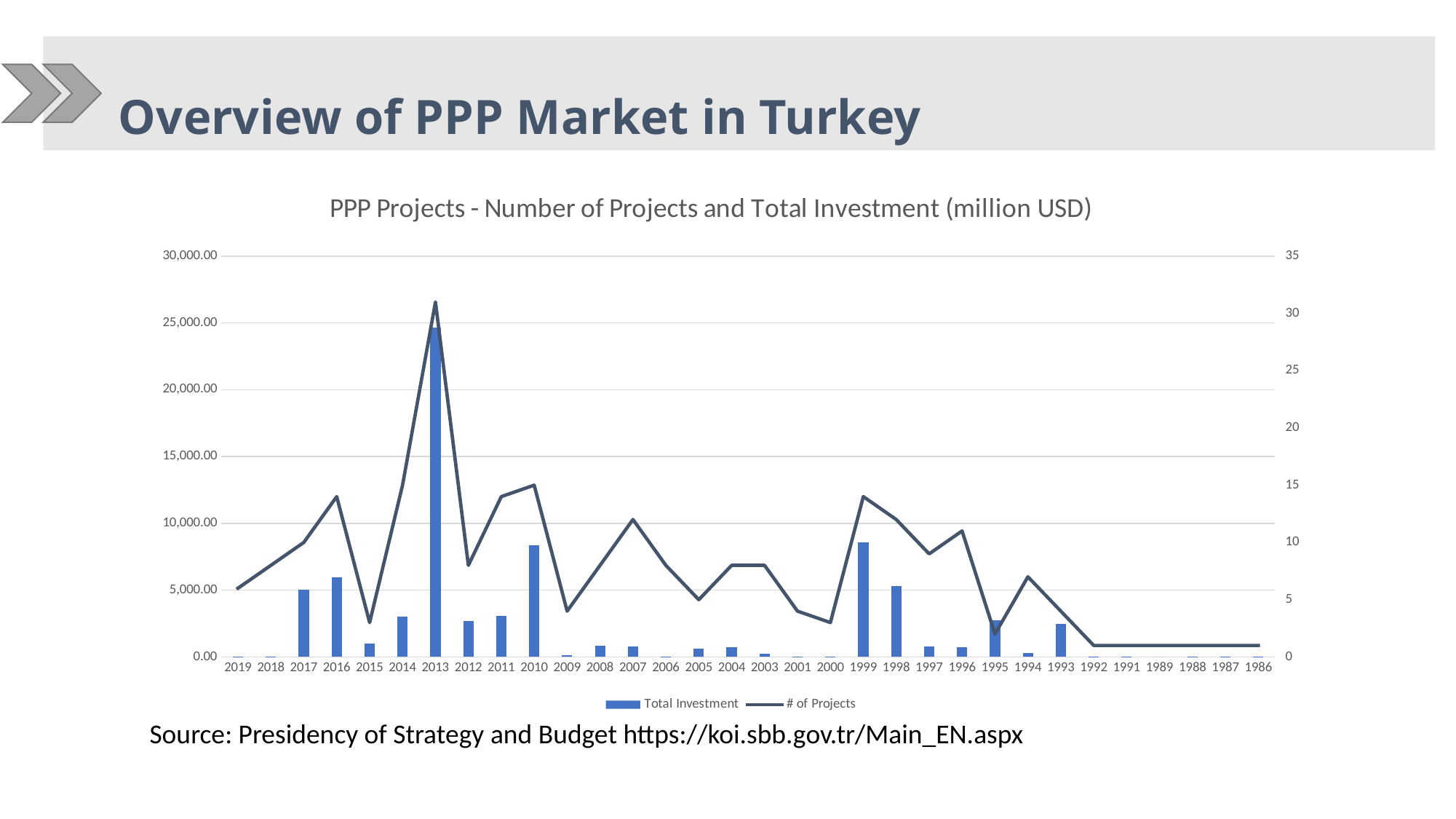
How many years are shown along the x axis of the chart? 32 Is the # of Projects for 2015 greater or less than 5? less Which year has the highest # of Projects? 2013 What is the title of the chart? PPP Projects - Number of Projects and Total Investment (million USD) Moving from 2019 to 2016 along the x axis, does the # of Projects line rise or fall? rise What kind of chart is shown on the slide? Combined bar and line chart Which year has the highest Total Investment? 2013 How many series does the chart legend list? 2 Is the Total Investment for 2013 greater or less than 20,000.00? greater Is the Total Investment for 2010 greater or less than 5,000.00? greater Which year has the larger Total Investment, 1999 or 1998? 1999